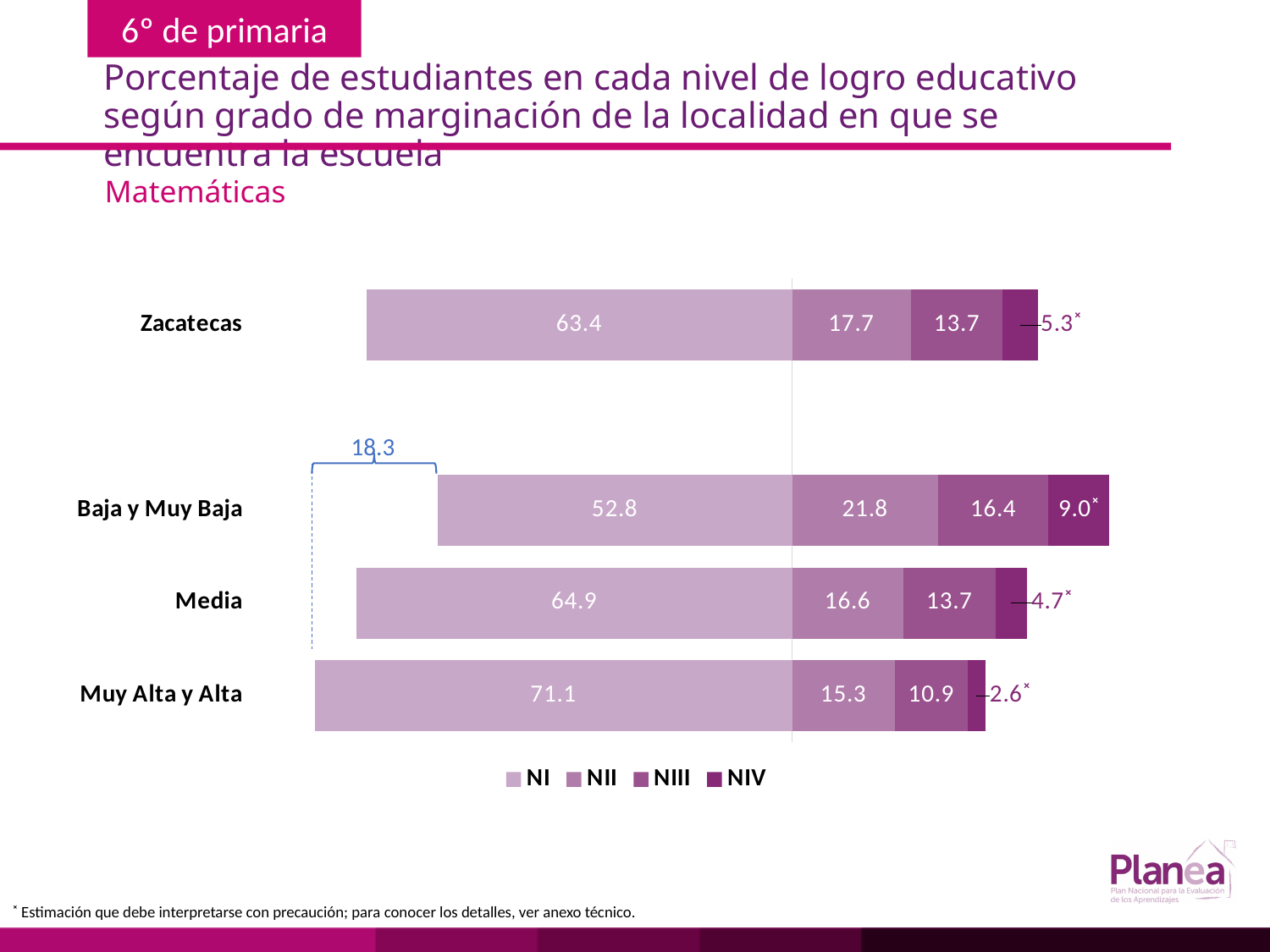
What is the difference between the NI value for Muy Alta y Alta and the NI value for Baja y Muy Baja? 18.3 What is the NIII value for Media? 13.7 How many categories are plotted on the chart? 4 Which is larger, the NII value for Zacatecas or the NII value for Media? Zacatecas What type of chart is shown on the slide? stacked bar chart Which category has the highest NI value? Muy Alta y Alta Which category has the lowest NIV value? Muy Alta y Alta What is the NII value for Baja y Muy Baja? 21.8 What is the NI value for Zacatecas? 63.4 What is the NIV value for Muy Alta y Alta? 2.6 What is the total of the stacked bar for Baja y Muy Baja? 100.0 How many series does the legend list? 4